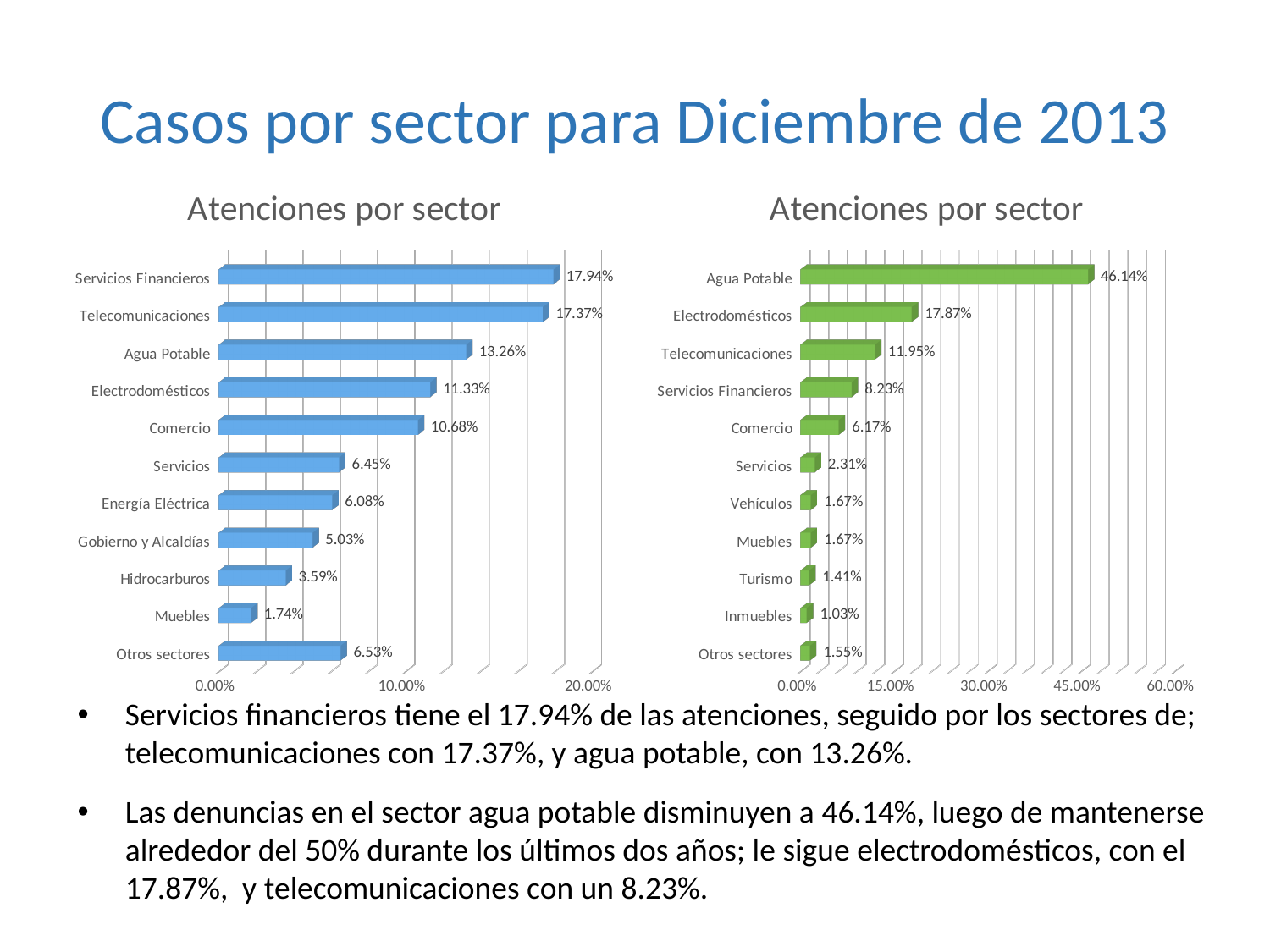
In the left chart, what is the value for Servicios Financieros? 17.94% In the right chart, which sector has the highest value? Agua Potable What is the title of the left chart? Atenciones por sector In the right chart, what is the value for Telecomunicaciones? 11.95% In the left chart, what is the value for Hidrocarburos? 3.59% In the right chart, which is larger, Electrodomésticos or Servicios Financieros? Electrodomésticos In the right chart, what is the value for Agua Potable? 46.14% What kind of chart is the right chart? Bar chart In the right chart, which sector has the lowest value? Inmuebles In the left chart, what is the difference between Servicios Financieros and Telecomunicaciones? 0.57% How many sectors are shown in the left chart? 11 In the left chart, which sector has the lowest value? Muebles